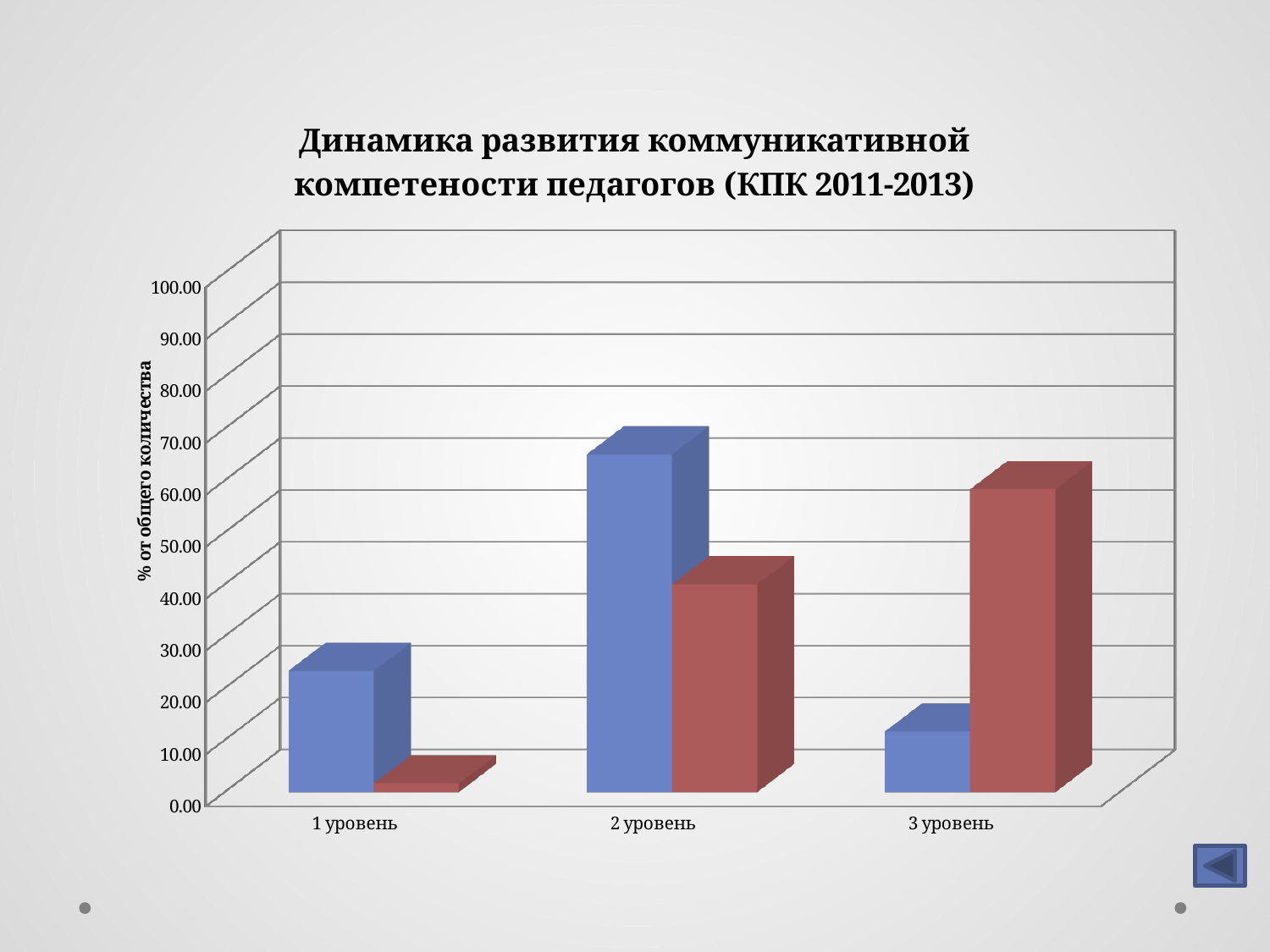
Is the value of the red bar for 1 уровень greater or less than 10.00? less For 3 уровень, which bar is taller, the blue one or the red one? red For 2 уровень, which bar is taller, the blue one or the red one? blue What kind of chart is shown on the slide? bar chart Which category has the tallest red bar? 3 уровень Is the value of the blue bar for 2 уровень greater or less than 50.00? greater Which category has the shortest red bar? 1 уровень What is the title of the chart? Динамика развития коммуникативной компетености педагогов (КПК 2011-2013) How many categories are shown on the x axis of the chart? 3 Which category has the tallest blue bar? 2 уровень Which category has the shortest blue bar? 3 уровень What is the label of the vertical axis? % от общего количества